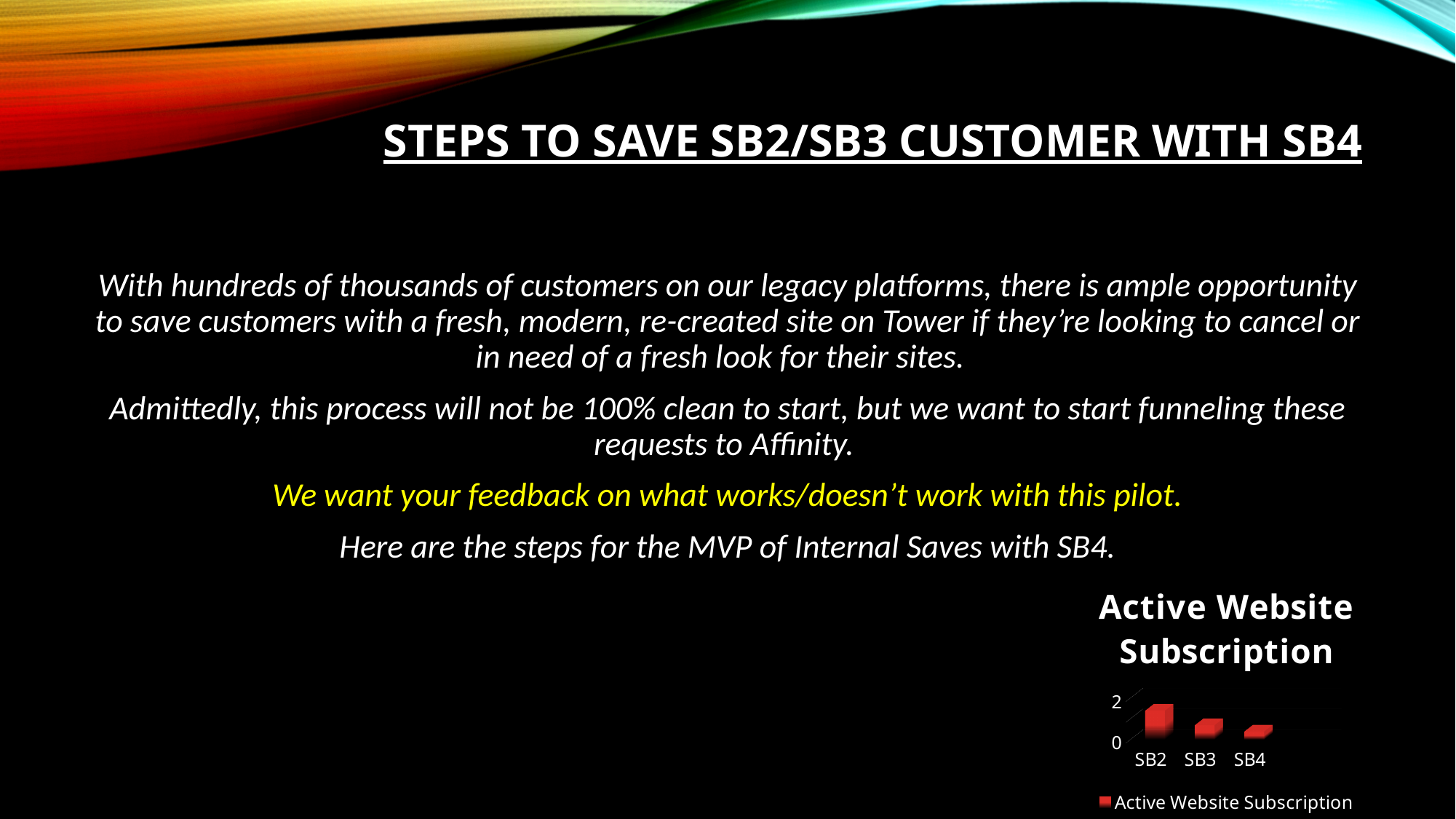
Which category has the lowest value in the chart? SB4 Do the values rise or fall from SB2 to SB4 along the x axis? fall How many categories are shown on the x axis of the chart? 3 Which category has the highest value in the chart? SB2 What series name appears in the chart legend? Active Website Subscription What kind of chart is shown on the slide? bar chart Which is larger, the value for SB3 or the value for SB4? SB3 How many series does the chart legend list? 1 Is the value for SB2 greater or less than 2? less Which is larger, the value for SB2 or the value for SB4? SB2 What is the title of the chart? Active Website Subscription What is the highest tick value shown on the chart's vertical axis? 2